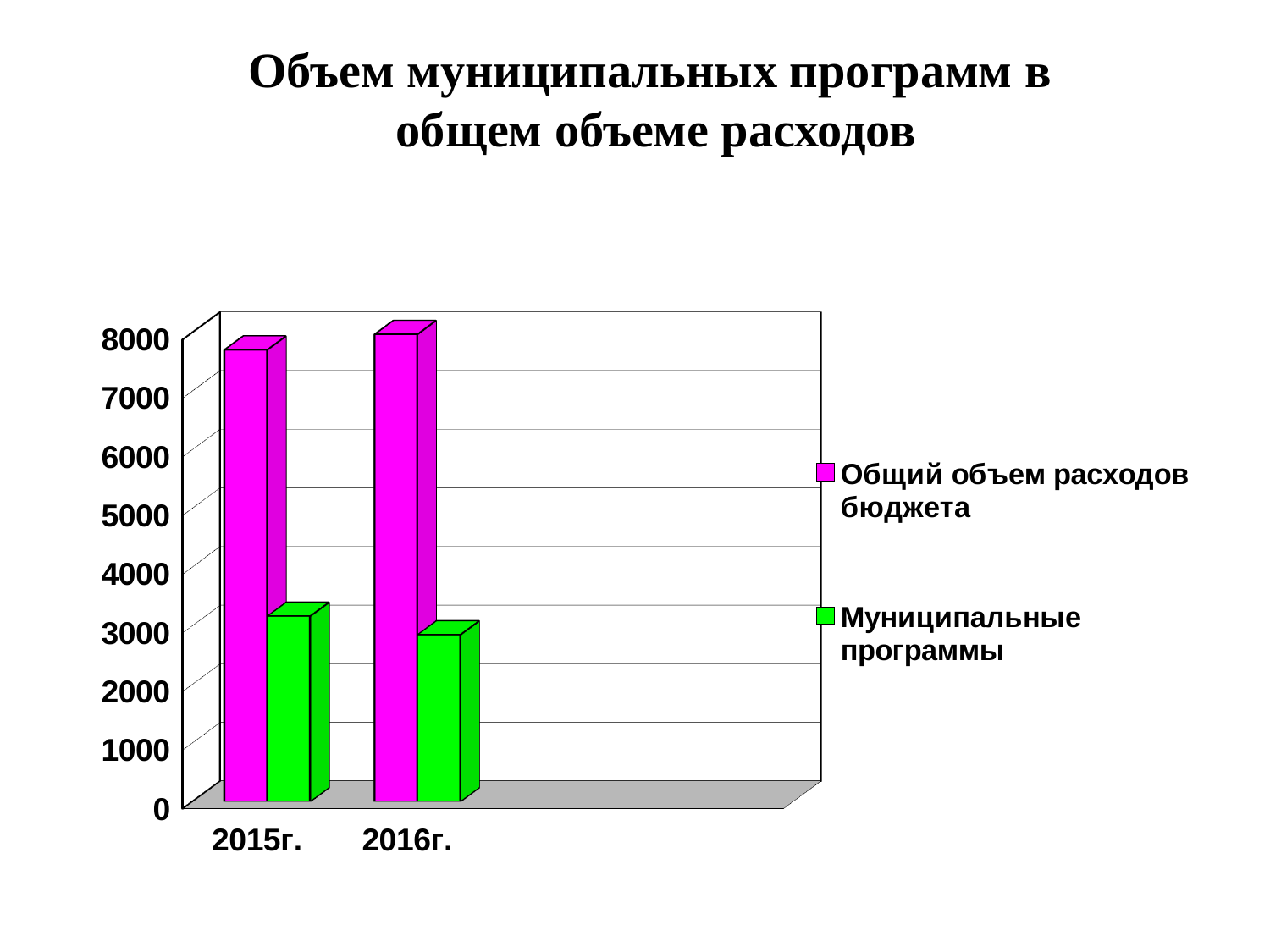
Which colour represents the series "Муниципальные программы"? Green Does the value of "Муниципальные программы" rise or fall from 2015г. to 2016г.? Fall Is the value of "Муниципальные программы" for 2015г. greater or less than 4000? less Is the value of "Муниципальные программы" for 2016г. greater or less than 2000? greater How many categories (years) are shown on the x axis? 2 Is the value of "Общий объем расходов бюджета" for 2015г. greater or less than 7000? greater Which year has the higher value for "Общий объем расходов бюджета", 2015г. or 2016г.? 2016г. Which year has the lower value for "Муниципальные программы"? 2016г. How many series does the legend list? 2 What kind of chart is shown on the slide? Bar chart What is the title of the chart? Объем муниципальных программ в общем объеме расходов